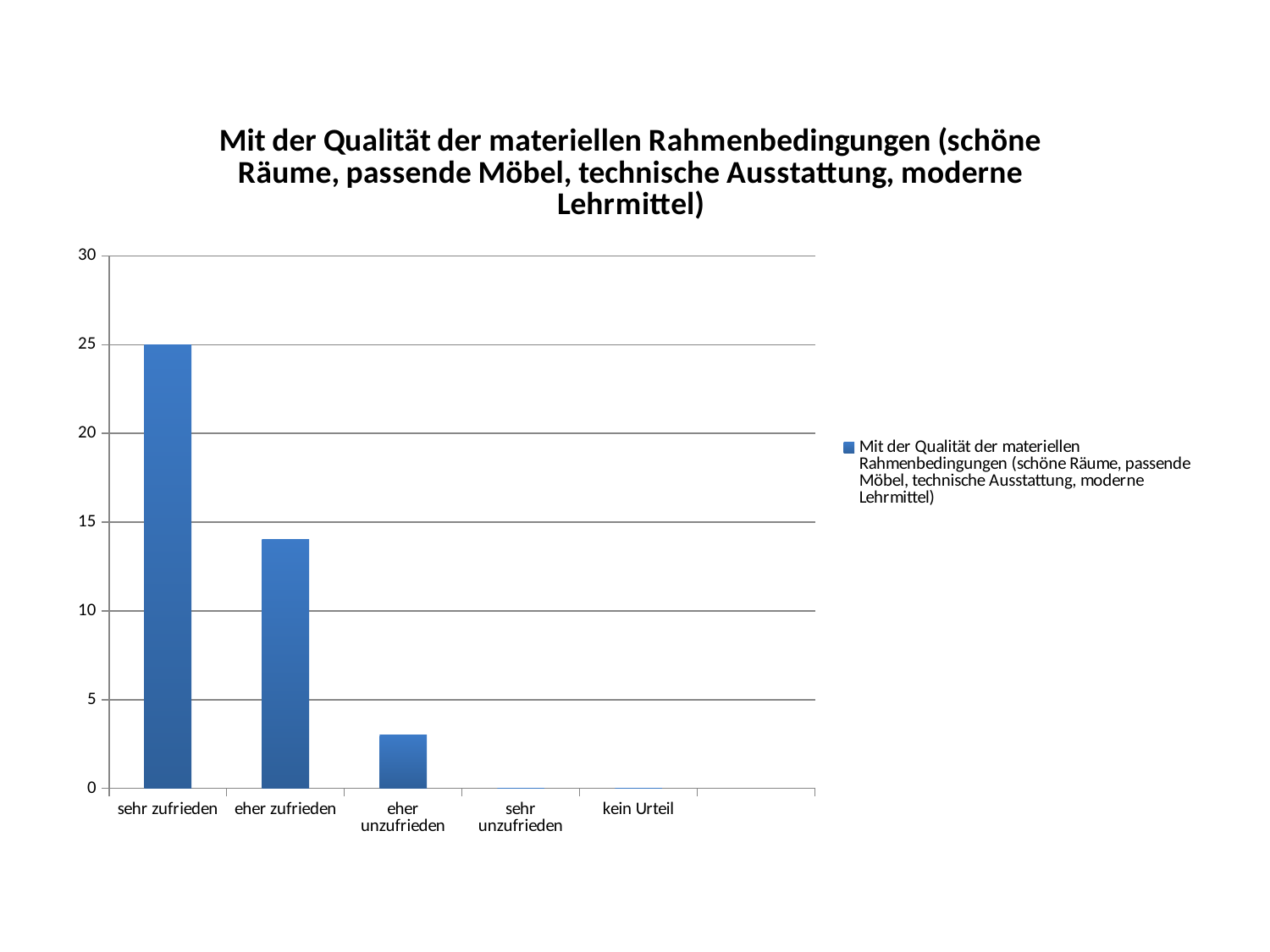
Is the value for "eher zufrieden" greater or less than 10? greater Do the bar values rise or fall from "sehr zufrieden" to "eher unzufrieden"? fall Which is larger, the value for "eher zufrieden" or the value for "eher unzufrieden"? eher zufrieden What kind of chart is shown on the slide? bar chart What is the value for "sehr zufrieden"? 25 Which category has the highest value? sehr zufrieden Is the value for "eher zufrieden" greater or less than 15? less What is the label of the last category on the x axis? kein Urteil Which is larger, the value for "sehr zufrieden" or the value for "eher zufrieden"? sehr zufrieden Is the value for "eher unzufrieden" greater or less than 5? less How many categories are shown on the x axis? 5 How many series does the legend list? 1